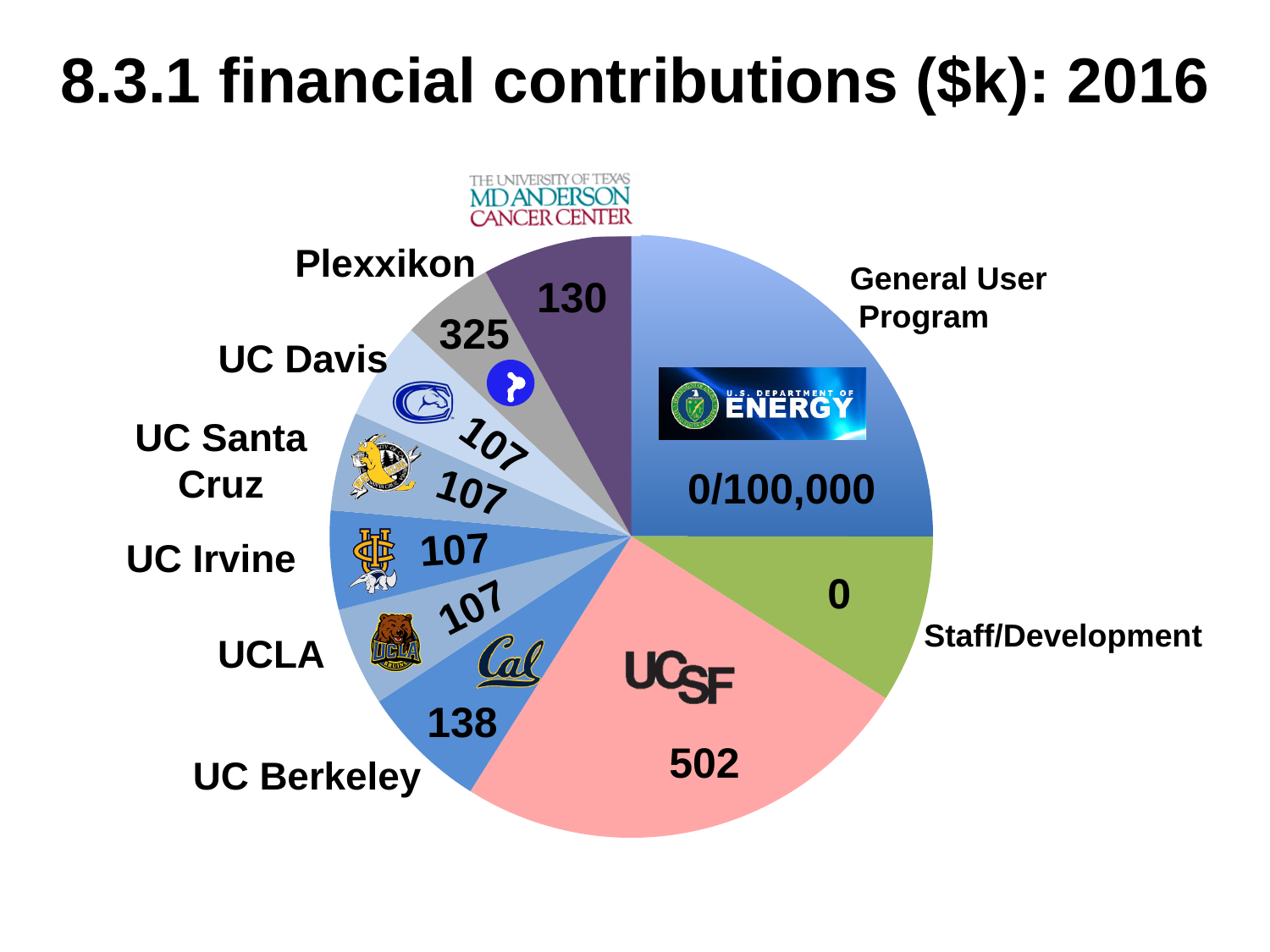
What value is printed on the Plexxikon slice? 325 What is the title of the chart on the slide? 8.3.1 financial contributions ($k): 2016 How many slices does the pie chart have? 10 What kind of chart is shown on the slide? pie chart What value is printed on the Staff/Development slice? 0 What value is printed on the UC Berkeley slice? 138 Which has the larger printed value, UCSF or Plexxikon? UCSF What value is printed on the UCSF slice? 502 What is the difference between the printed values for UCSF and UC Berkeley? 364 What value is printed on the General User Program slice? 0/100,000 What value is printed on the UC Davis slice? 107 What is the difference between the printed values for Plexxikon and the MD Anderson Cancer Center slice? 195